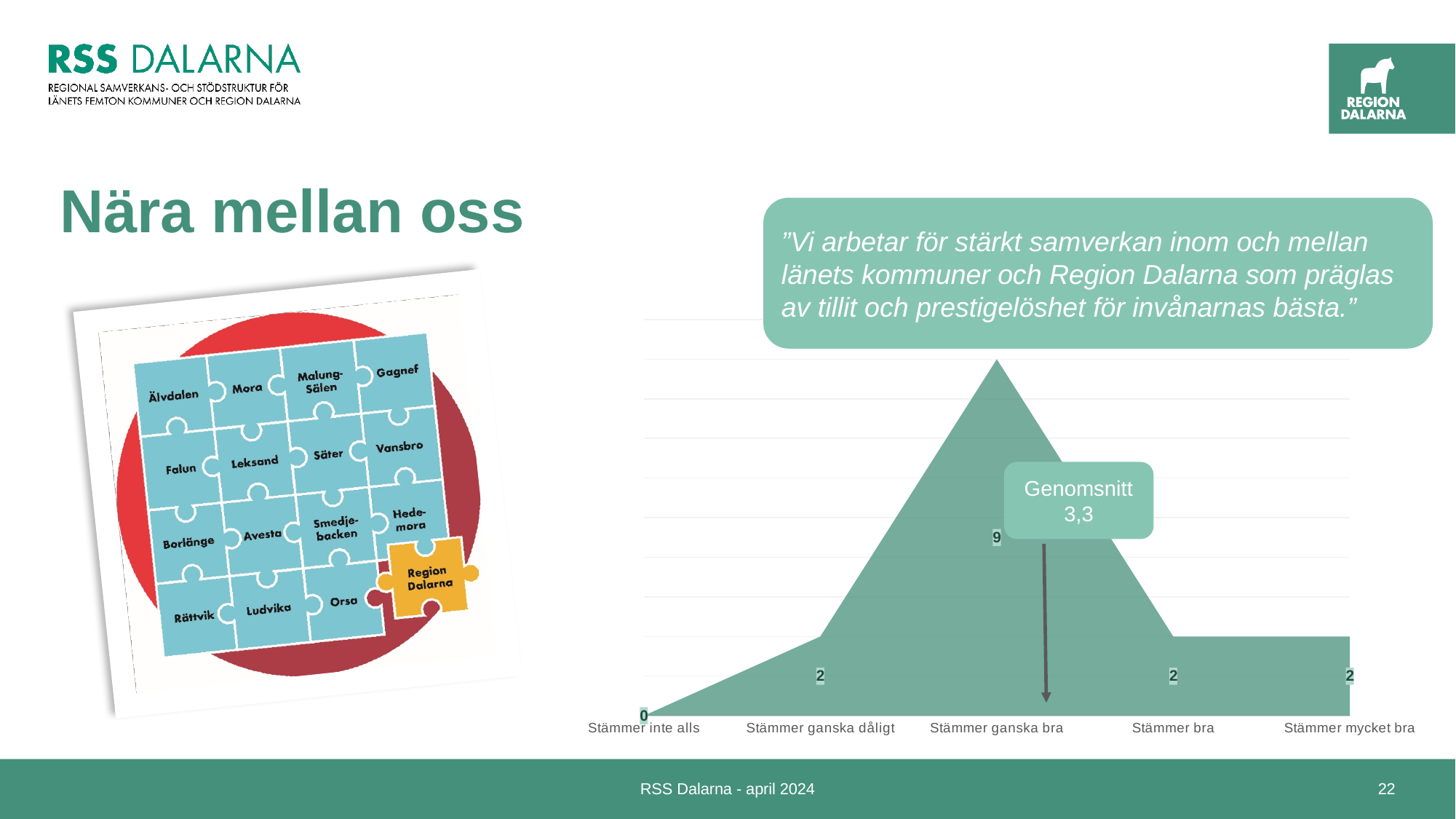
Which category has the highest value? Stämmer ganska bra What average (Genomsnitt) value is shown in the callout on the chart? 3,3 How many categories are shown on the x axis of the chart? 5 Which is larger, the value for "Stämmer ganska bra" or the value for "Stämmer ganska dåligt"? Stämmer ganska bra What is the value for "Stämmer ganska dåligt"? 2 What kind of chart is shown on the slide? Area chart What is the total of all the values plotted in the chart? 15 What is the value for "Stämmer inte alls"? 0 Which category has the lowest value? Stämmer inte alls What is the value for "Stämmer mycket bra"? 2 What is the value for "Stämmer ganska bra"? 9 What is the difference between the values for "Stämmer ganska bra" and "Stämmer bra"? 7